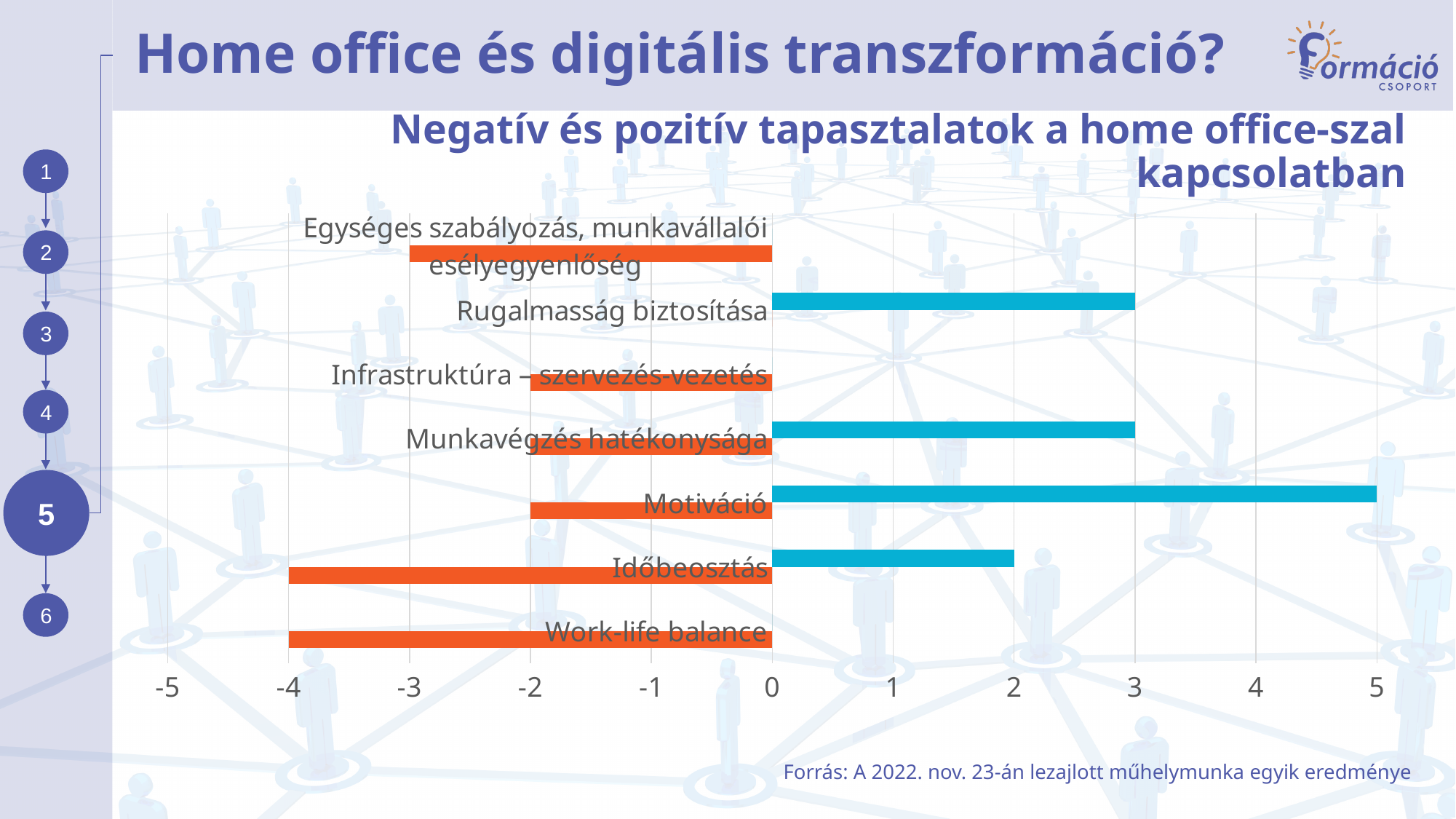
What is the value of the blue (positive) bar for Motiváció? 5 How many categories are listed on the chart? 7 What is the value of the orange (negative) bar for Időbeosztás? -4 What is the difference between the blue bar for Motiváció and the blue bar for Időbeosztás? 3 What is the title of the chart? Negatív és pozitív tapasztalatok a home office-szal kapcsolatban What is the value of the blue (positive) bar for Rugalmasság biztosítása? 3 What is the value of the orange (negative) bar for Infrastruktúra – szervezés-vezetés? -2 Which category has the longest blue (positive) bar? Motiváció Which is longer: the blue bar for Munkavégzés hatékonysága or the blue bar for Időbeosztás? Munkavégzés hatékonysága What kind of chart is shown on the slide? bar chart What is the value of the orange (negative) bar for Work-life balance? -4 Which category has the shortest blue (positive) bar? Időbeosztás